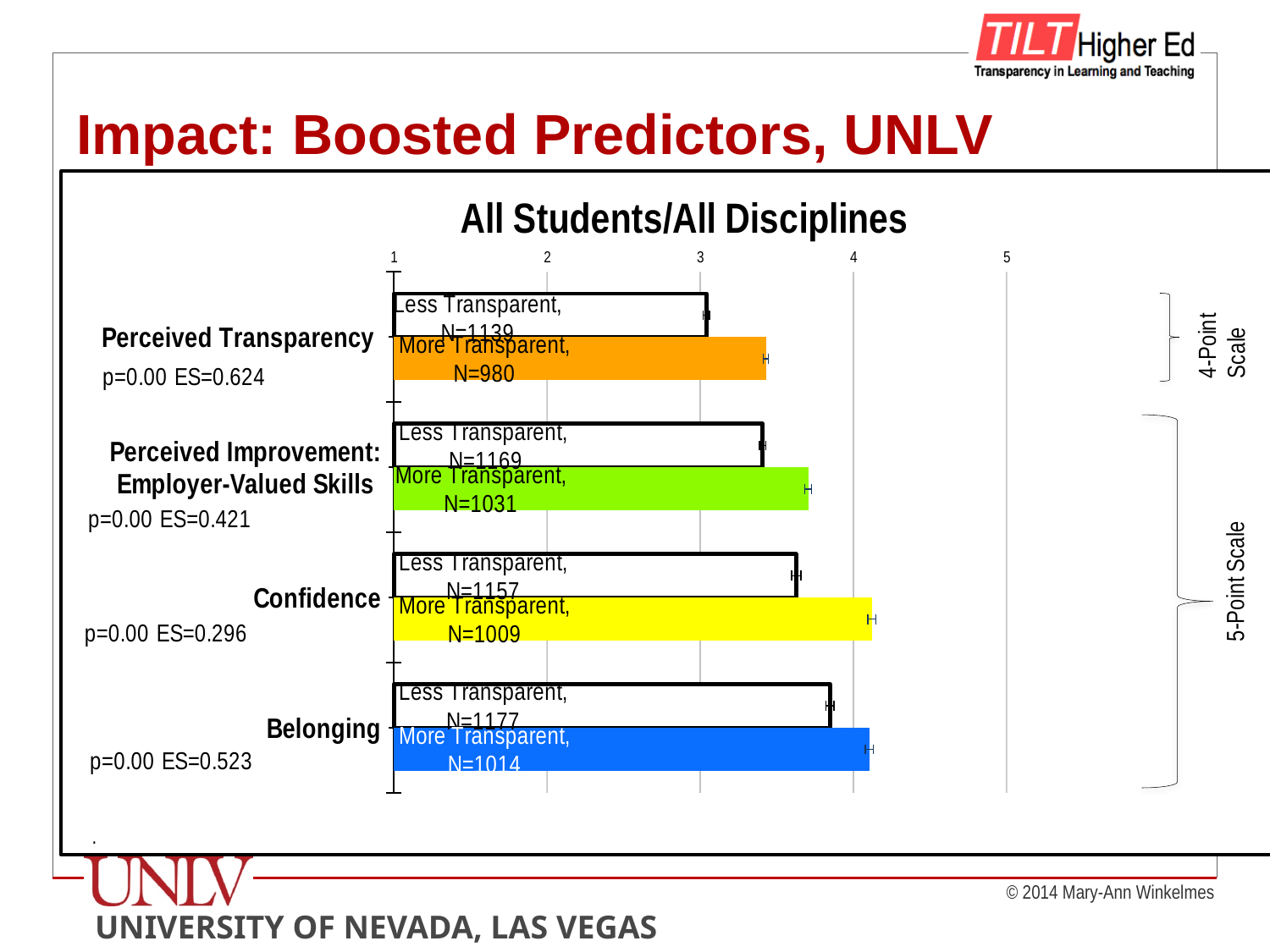
In the Confidence category, which bar is longer: Less Transparent or More Transparent? More Transparent What is the N for the More Transparent group in the Perceived Transparency category? N=980 In the Perceived Transparency category, which bar is longer: Less Transparent or More Transparent? More Transparent What is the title of the chart? All Students/All Disciplines Is the value for the Less Transparent bar in Belonging greater or less than 4? less What kind of chart is shown on the slide? bar chart Is the value for the Less Transparent bar in Perceived Improvement: Employer-Valued Skills greater or less than 3? greater What is the N for the More Transparent group in the Confidence category? N=1009 Which bar on the chart is the shortest? Less Transparent, Perceived Transparency Is the value for the More Transparent bar in Perceived Transparency greater or less than 4? less How many outcome categories are plotted on the chart? 4 What is the N for the Less Transparent group in the Belonging category? N=1177